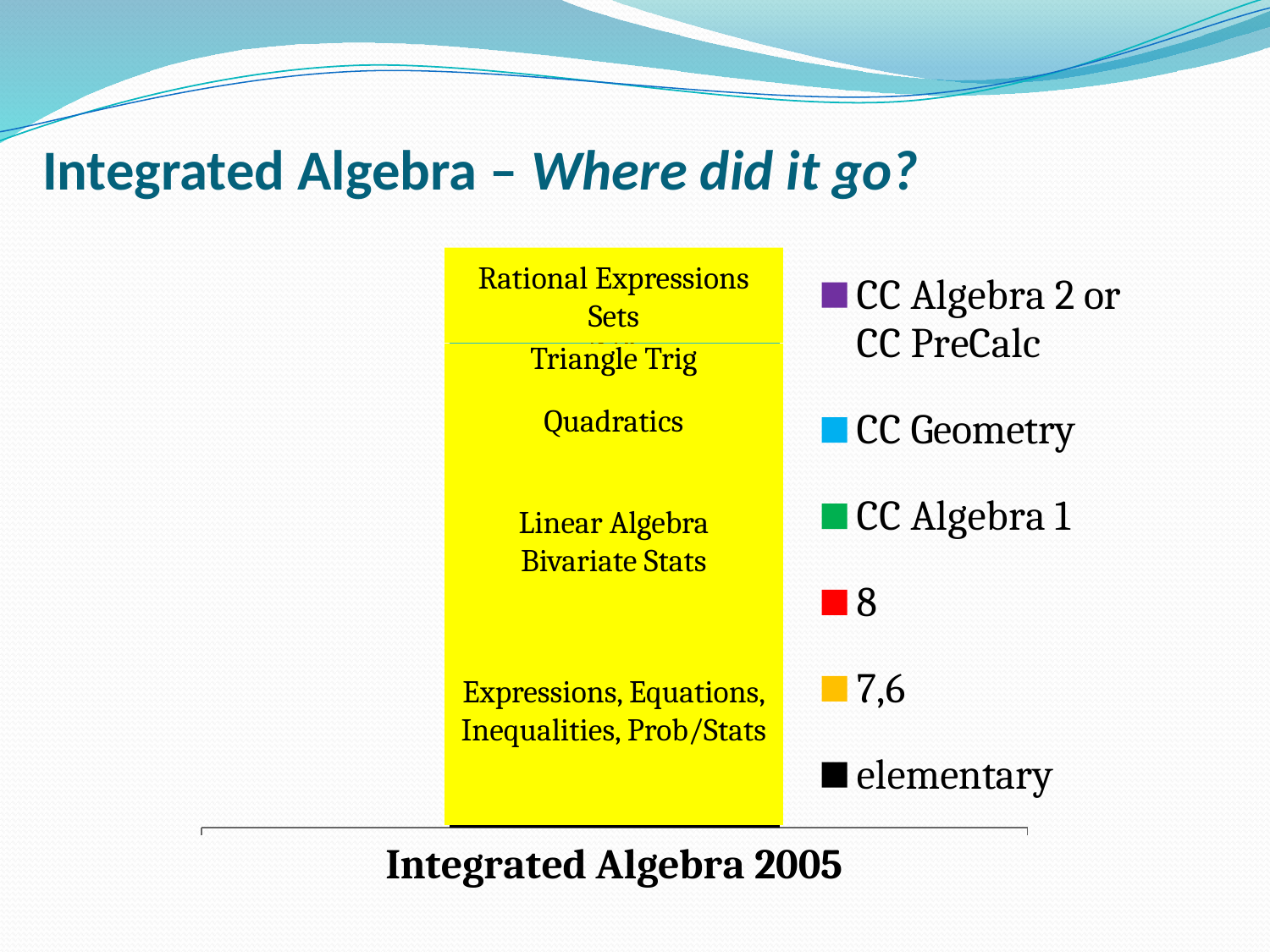
What is the label of the single category on the x axis? Integrated Algebra 2005 How many categories are shown on the x axis of the chart? 1 Which legend entry is shown with a black marker? elementary Which legend entry is shown with a light blue marker? CC Geometry How many series does the chart's legend list? 6 What kind of chart is shown on the slide? bar chart